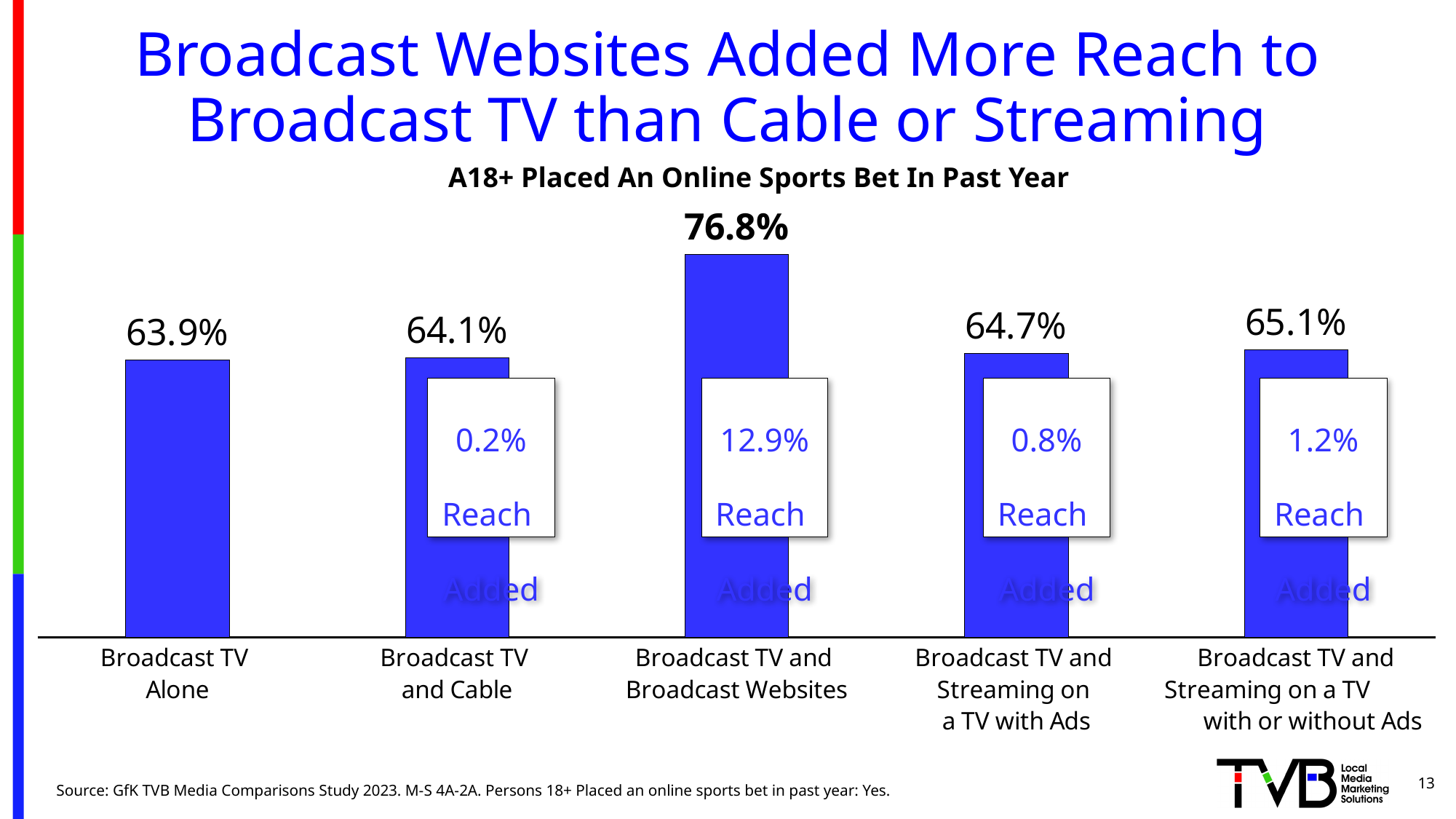
What is the subtitle printed above the chart? A18+ Placed An Online Sports Bet In Past Year What kind of chart is shown on the slide? Bar chart How many categories are shown in the chart? 5 What is the value for Broadcast TV and Streaming on a TV with Ads? 64.7% How much added reach does the box for Broadcast TV and Cable show? 0.2% What is the value for Broadcast TV and Streaming on a TV with or without Ads? 65.1% What is the difference between the values for Broadcast TV and Broadcast Websites and Broadcast TV Alone? 12.9% What is the value for Broadcast TV and Cable? 64.1% What is the value for Broadcast TV Alone? 63.9% Which category has the lowest value? Broadcast TV Alone What is the value for Broadcast TV and Broadcast Websites? 76.8% Which category has the highest value? Broadcast TV and Broadcast Websites